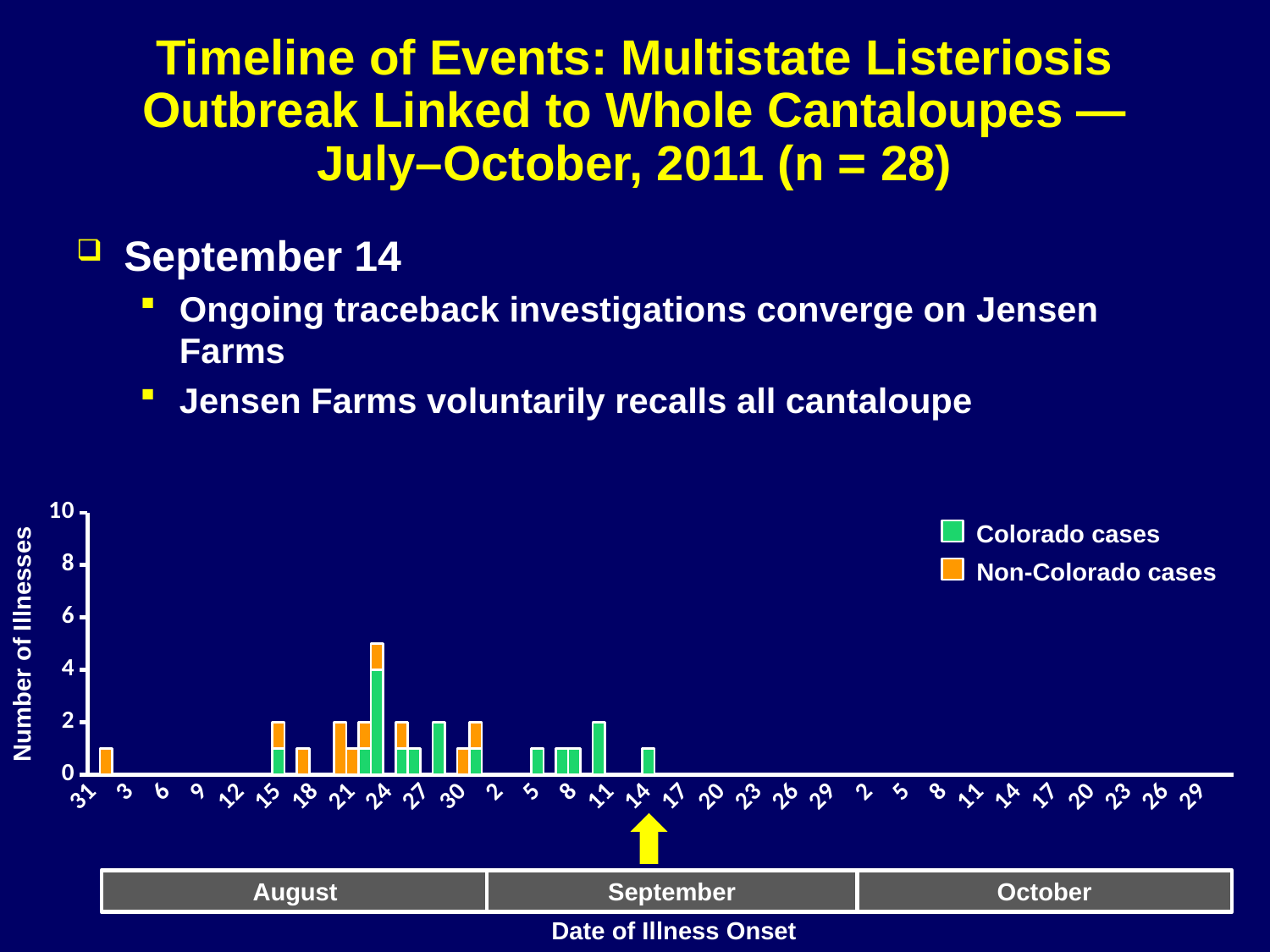
What kind of chart is shown on the slide? Stacked bar chart Is the value of the tallest bar (around August 24) greater or less than 6? less Do the number of illnesses generally rise or fall from late August to mid-September? fall What is the highest value shown on the y-axis of the chart? 10 What are the two series named in the chart legend? Colorado cases and Non-Colorado cases In which month does the tallest bar of the chart occur? August What date does the yellow arrow below the chart point to? September 14 Is the value of the tallest bar (around August 24) greater or less than 4? greater How many bars are plotted in the October section of the chart? 0 Which month has more bars plotted, August or September? August How many series does the chart legend list? 2 What colour represents Colorado cases in the chart? Green